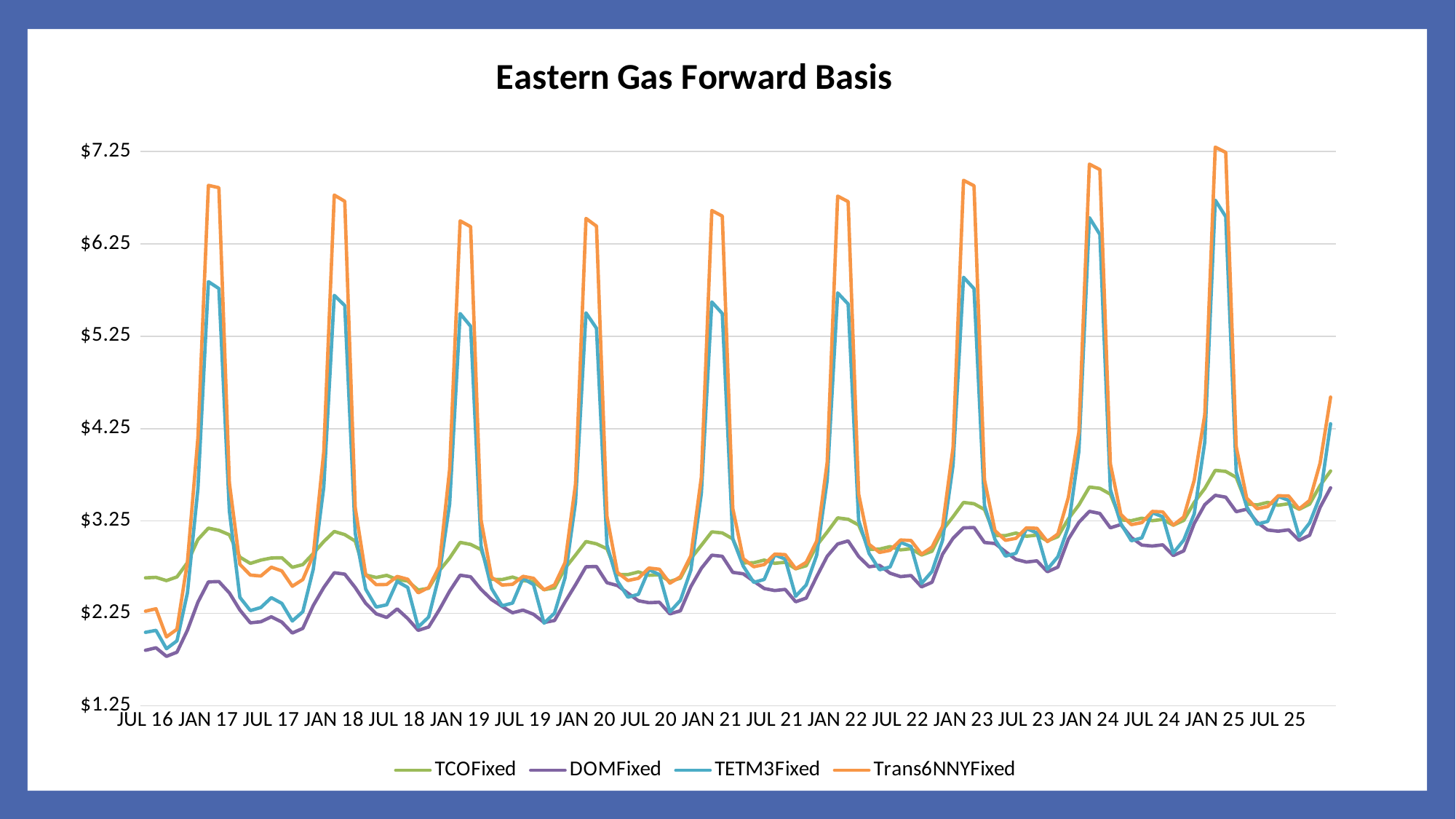
Is the peak value of DOMFixed near JAN 25 greater or less than $4.25? less At the JAN 17 peak, which is larger: Trans6NNYFixed or TETM3Fixed? Trans6NNYFixed Is the value of DOMFixed at JUL 16 greater or less than $2.25? less Which series reaches the highest peaks on the chart? Trans6NNYFixed Is the peak value of Trans6NNYFixed near JAN 17 greater or less than $6.25? greater How many labels are shown along the x axis? 19 Does the DOMFixed series generally rise or fall from JUL 16 to JUL 25? rise Which series is shown in orange in the legend? Trans6NNYFixed What is the title of the chart? Eastern Gas Forward Basis What kind of chart is shown on the slide? line chart Which series has the lowest value at JUL 16? DOMFixed How many series does the legend list? 4